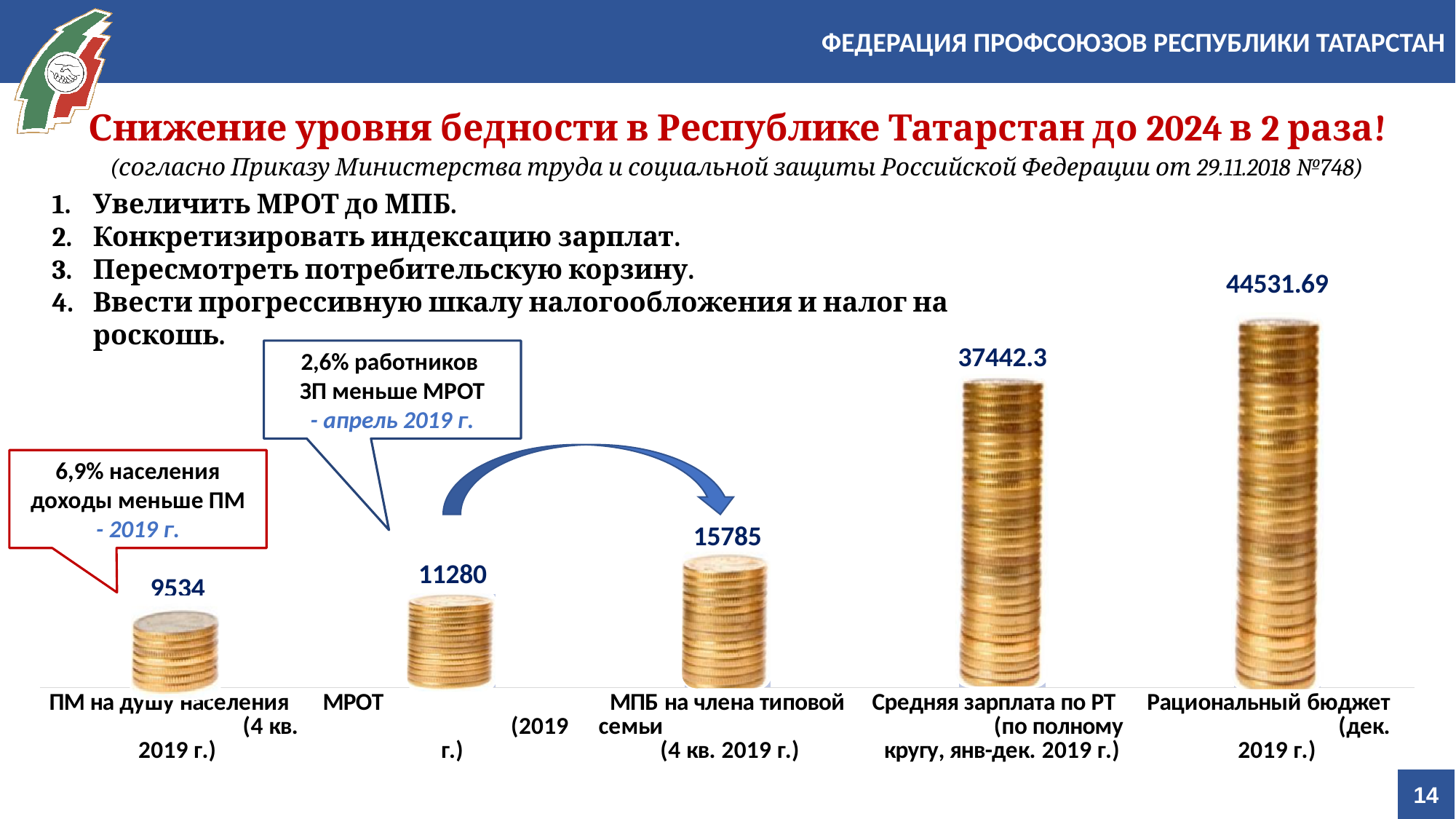
Which category has the lowest value? ПМ на душу населения (4 кв. 2019 г.) What is the difference between МРОТ and ПМ на душу населения? 1746 What is the value shown for Средняя зарплата по РТ (по полному кругу, янв-дек. 2019 г.)? 37442.3 What is the difference between МПБ на члена типовой семьи and МРОТ? 4505 How many categories are shown in the chart? 5 Do the values rise or fall from left to right across the chart? rise What is the value shown for Рациональный бюджет (дек. 2019 г.)? 44531.69 Which category has the highest value? Рациональный бюджет (дек. 2019 г.) Which is larger, Средняя зарплата по РТ or Рациональный бюджет? Рациональный бюджет What is the value shown for МПБ на члена типовой семьи (4 кв. 2019 г.)? 15785 What is the value shown for МРОТ (2019 г.)? 11280 What is the value shown for ПМ на душу населения (4 кв. 2019 г.)? 9534